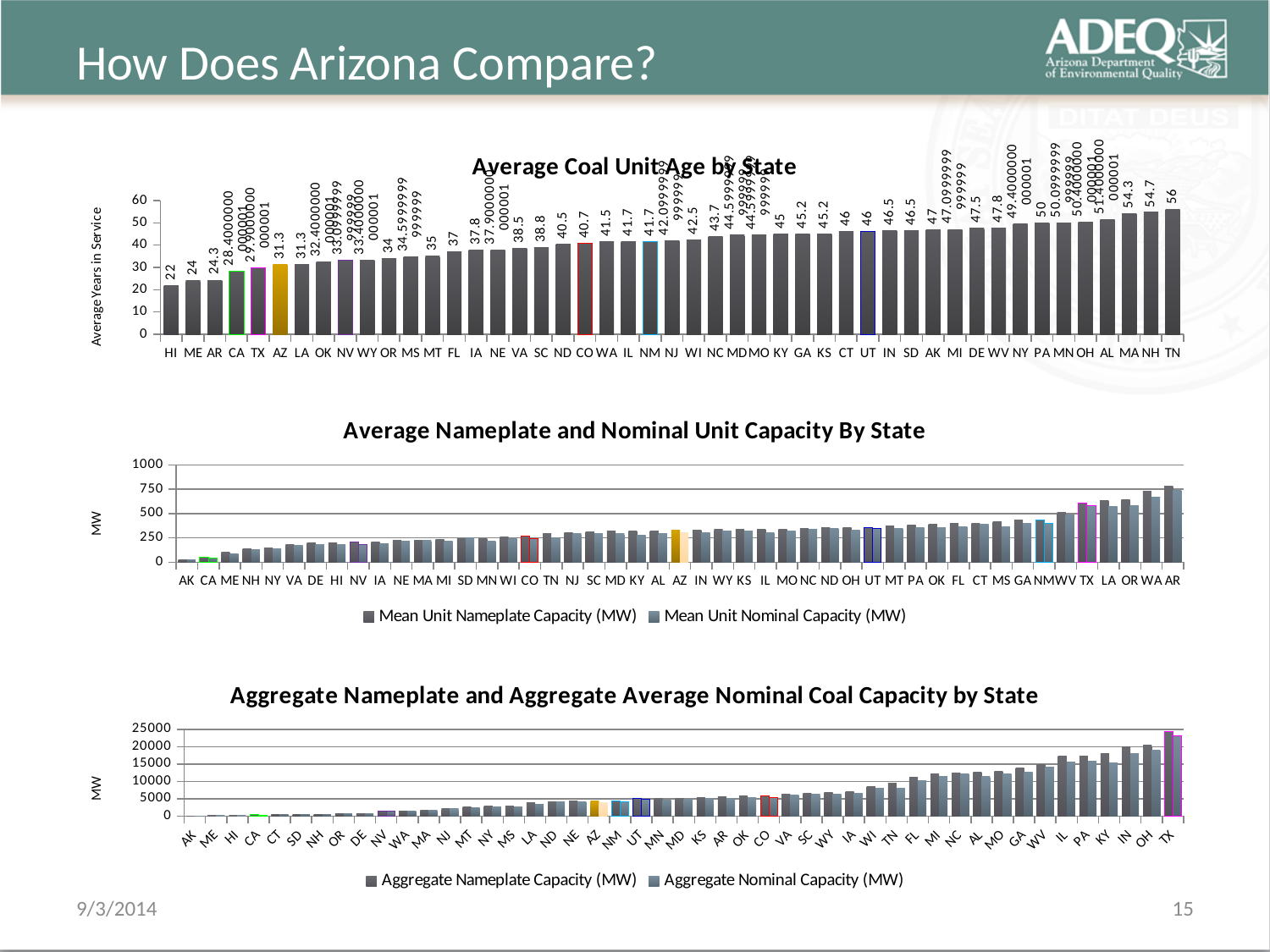
In the 'Average Coal Unit Age by State' chart, what is the difference between the values for TN and HI? 34 In the 'Average Nameplate and Nominal Unit Capacity By State' chart, is the Mean Unit Nameplate Capacity for AR greater or less than 500? greater What kind of chart is the 'Average Coal Unit Age by State' chart? bar chart What is the y-axis label of the 'Aggregate Nameplate and Aggregate Average Nominal Coal Capacity by State' chart? MW In the 'Aggregate Nameplate and Aggregate Average Nominal Coal Capacity by State' chart, is the Aggregate Nameplate Capacity for TX greater or less than 20000? greater How many series does the legend of the 'Average Nameplate and Nominal Unit Capacity By State' chart list? 2 In the 'Average Coal Unit Age by State' chart, which is larger, the value for MA or the value for FL? MA In the 'Average Coal Unit Age by State' chart, which state has the lowest average age? HI In the 'Average Coal Unit Age by State' chart, do the values rise or fall from left to right along the x axis? rise In the 'Average Coal Unit Age by State' chart, what is the value for TN? 56 In the 'Average Coal Unit Age by State' chart, which state has the highest average age? TN In the 'Average Coal Unit Age by State' chart, what is the value for AZ? 31.3